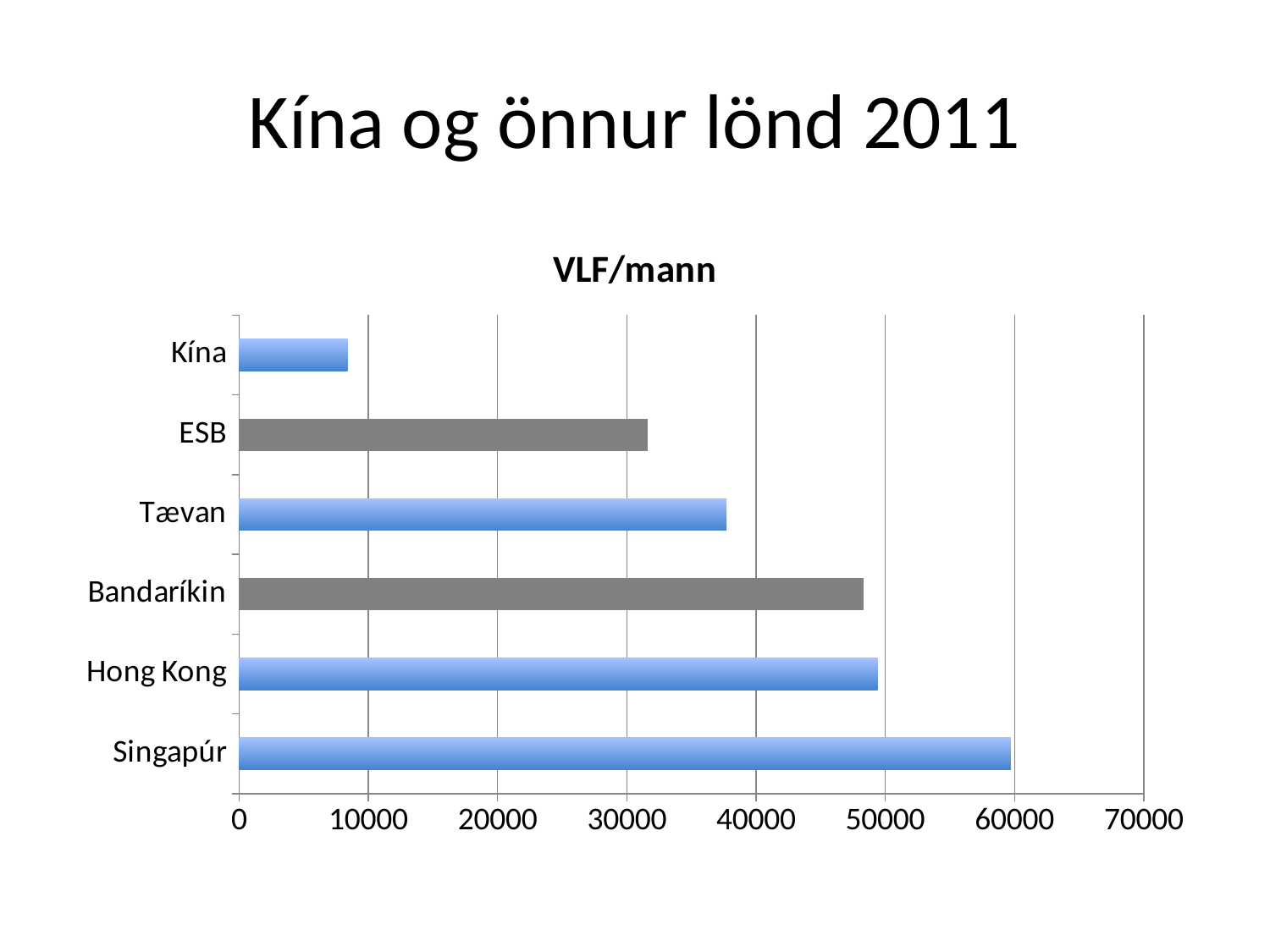
Which is larger, the value for Tævan or the value for ESB? Tævan Is the value for Singapúr greater or less than 50000? greater Which category has the highest VLF/mann value? Singapúr Is the value for Kína greater or less than 10000? less Is the value for Bandaríkin greater or less than 50000? less Which category has the lowest VLF/mann value? Kína How many countries or regions are shown in the chart? 6 What is the title of the chart? VLF/mann What kind of chart is shown on the slide? bar chart Which is larger, the value for Singapúr or the value for Hong Kong? Singapúr